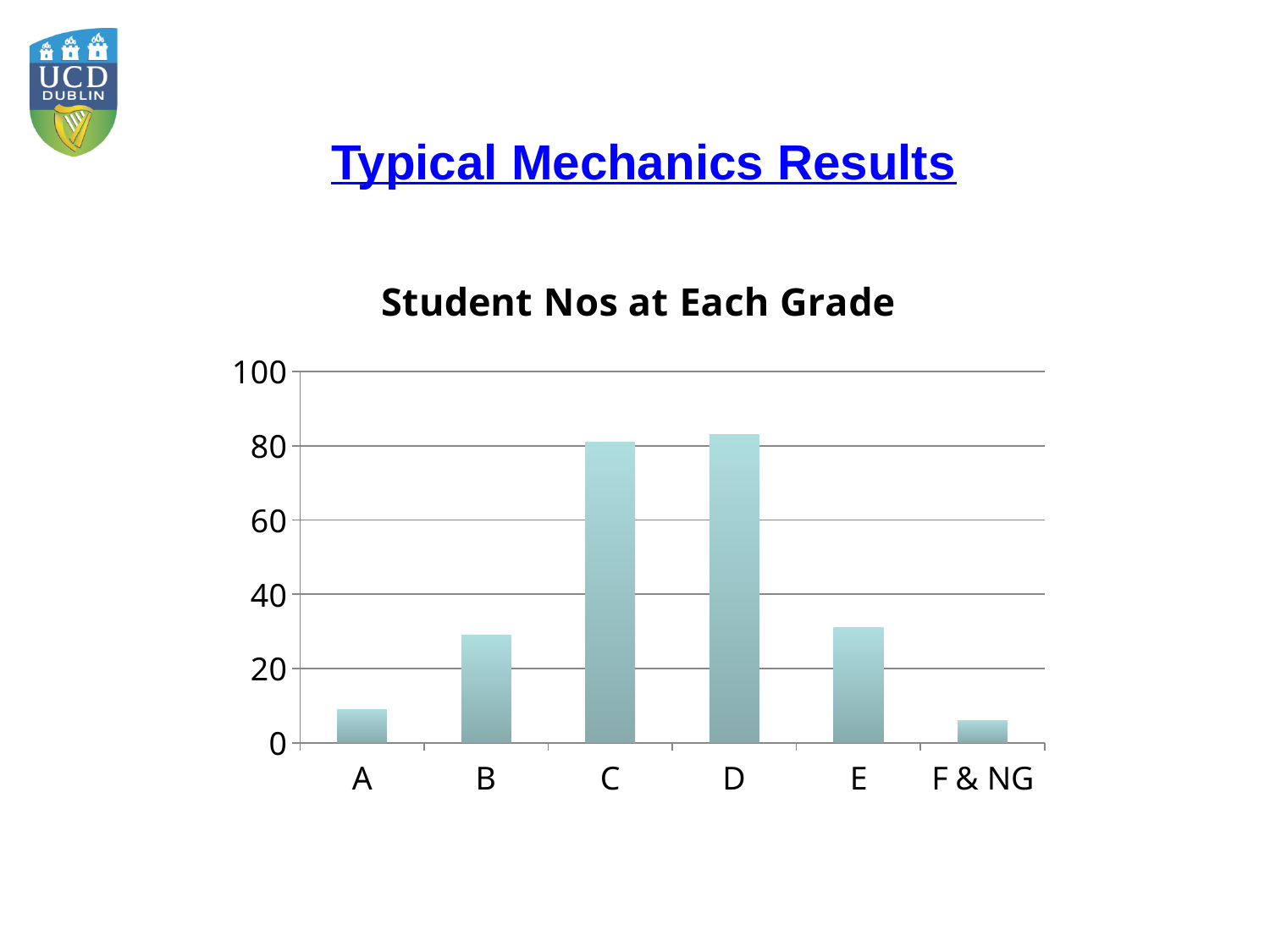
Which has more students, grade E or F & NG? E Is the value for F & NG greater or less than 20? less What kind of chart is shown on the slide? bar chart Is the value for grade C greater or less than 60? greater What is the title of the chart? Student Nos at Each Grade Is the value for grade D greater or less than 60? greater Which has more students, grade A or grade B? B Which has more students, grade C or grade B? C How many grade categories are shown on the x axis? 6